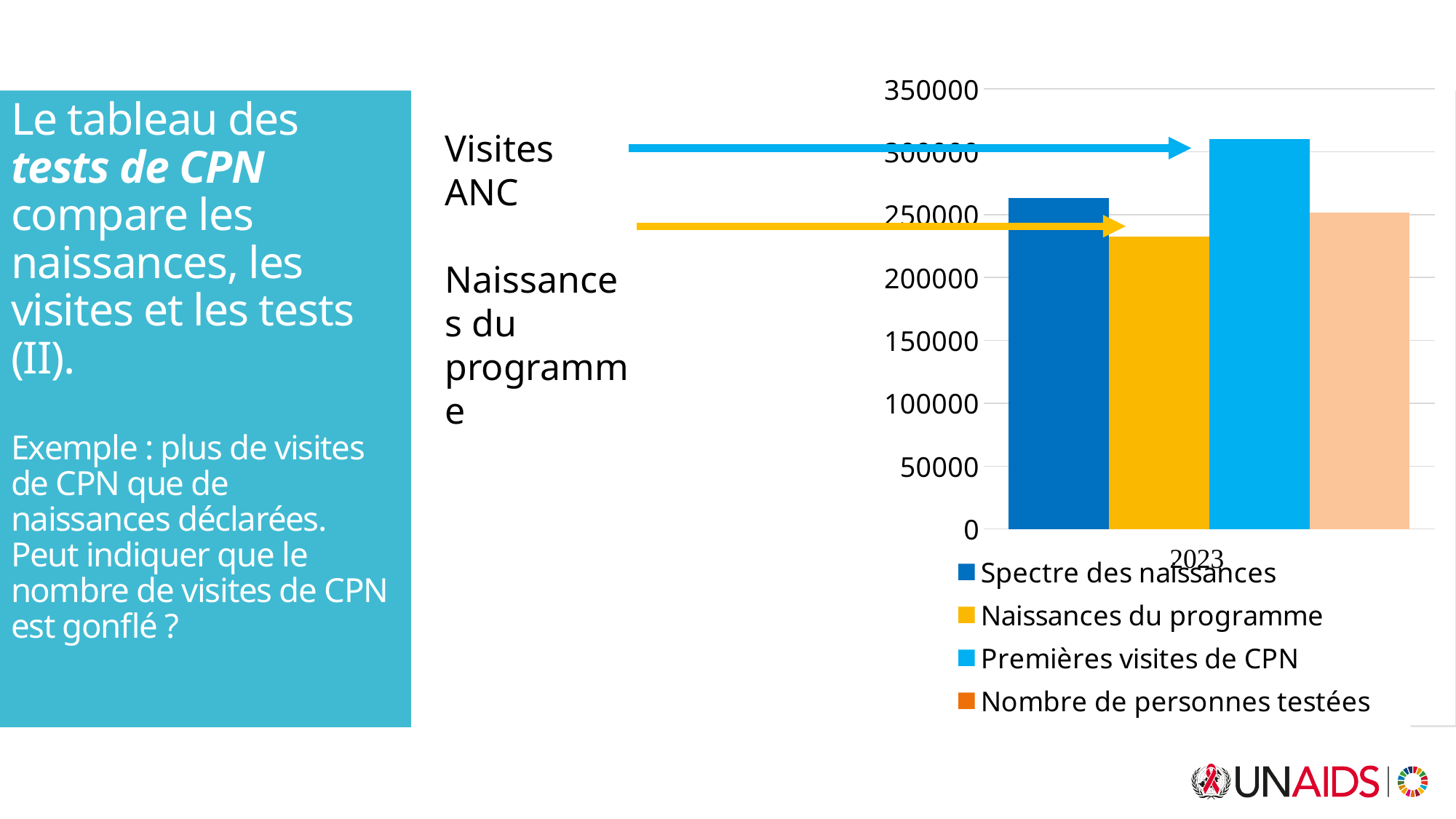
Is the value for Naissances du programme greater or less than 250000? less How many series does the chart legend list? 4 Is the value for Nombre de personnes testées greater or less than 200000? greater Which series has the lowest bar in the chart? Naissances du programme Which is larger, Spectre des naissances or Naissances du programme? Spectre des naissances What year is shown as the category label on the x axis of the chart? 2023 How many categories are shown on the x axis of the chart? 1 What kind of chart is shown on the slide? bar chart Is the value for Spectre des naissances greater or less than 250000? greater Which is larger, Premières visites de CPN or Nombre de personnes testées? Premières visites de CPN Which series has the highest bar in the chart? Premières visites de CPN